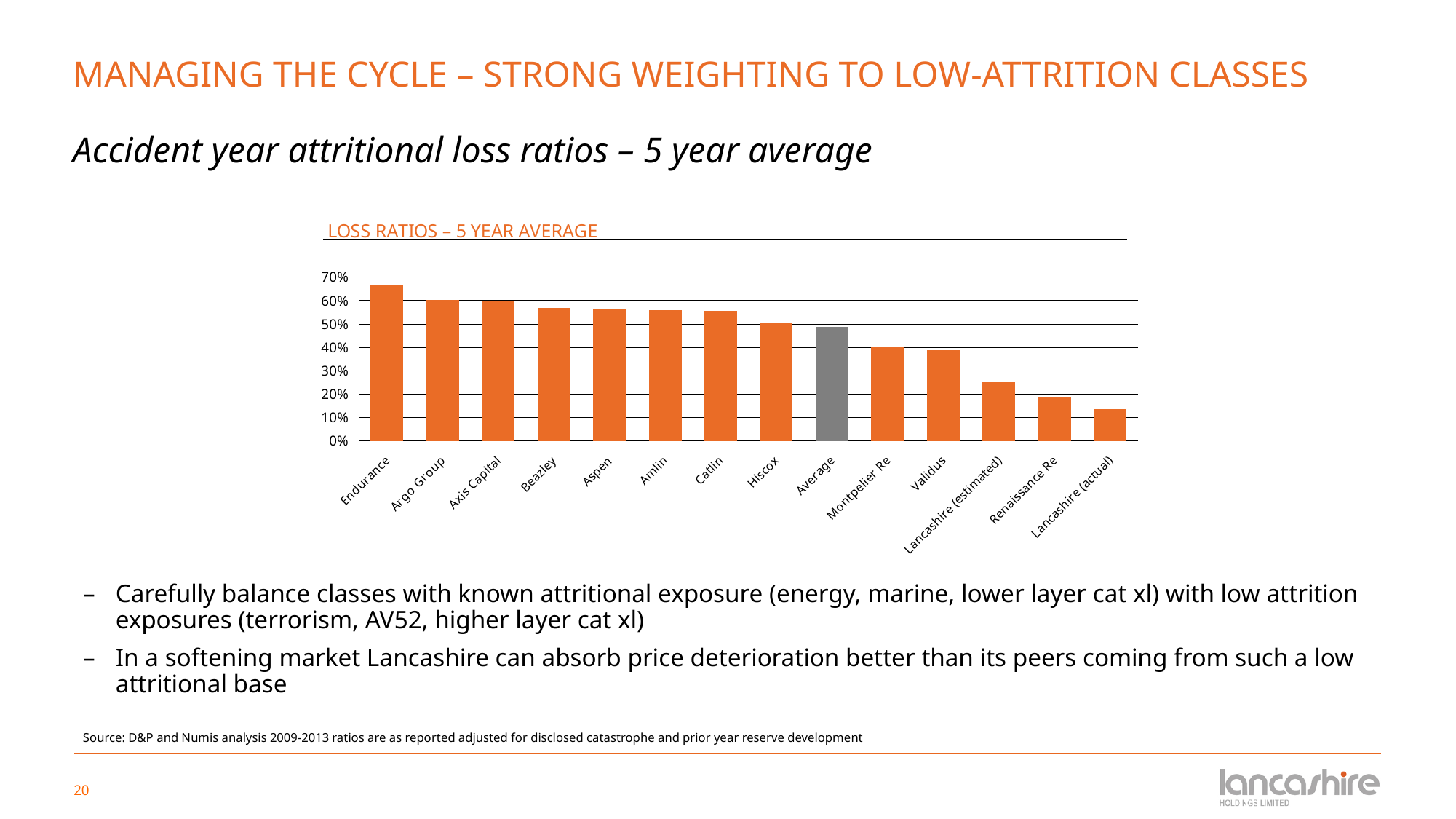
Is the value for Endurance greater or less than 60%? greater Do the loss ratios rise or fall moving from left to right across the chart? Fall Is the value for Montpelier Re greater or less than 30%? greater Which has a higher loss ratio, Beazley or Validus? Beazley Which bar in the chart is coloured grey rather than orange? Average What kind of chart is shown on the slide? Bar chart Is the value for Lancashire (estimated) greater or less than 30%? less How many bars are plotted in the chart? 14 Which category has the lowest 5 year average loss ratio? Lancashire (actual) Which company has the highest 5 year average loss ratio? Endurance